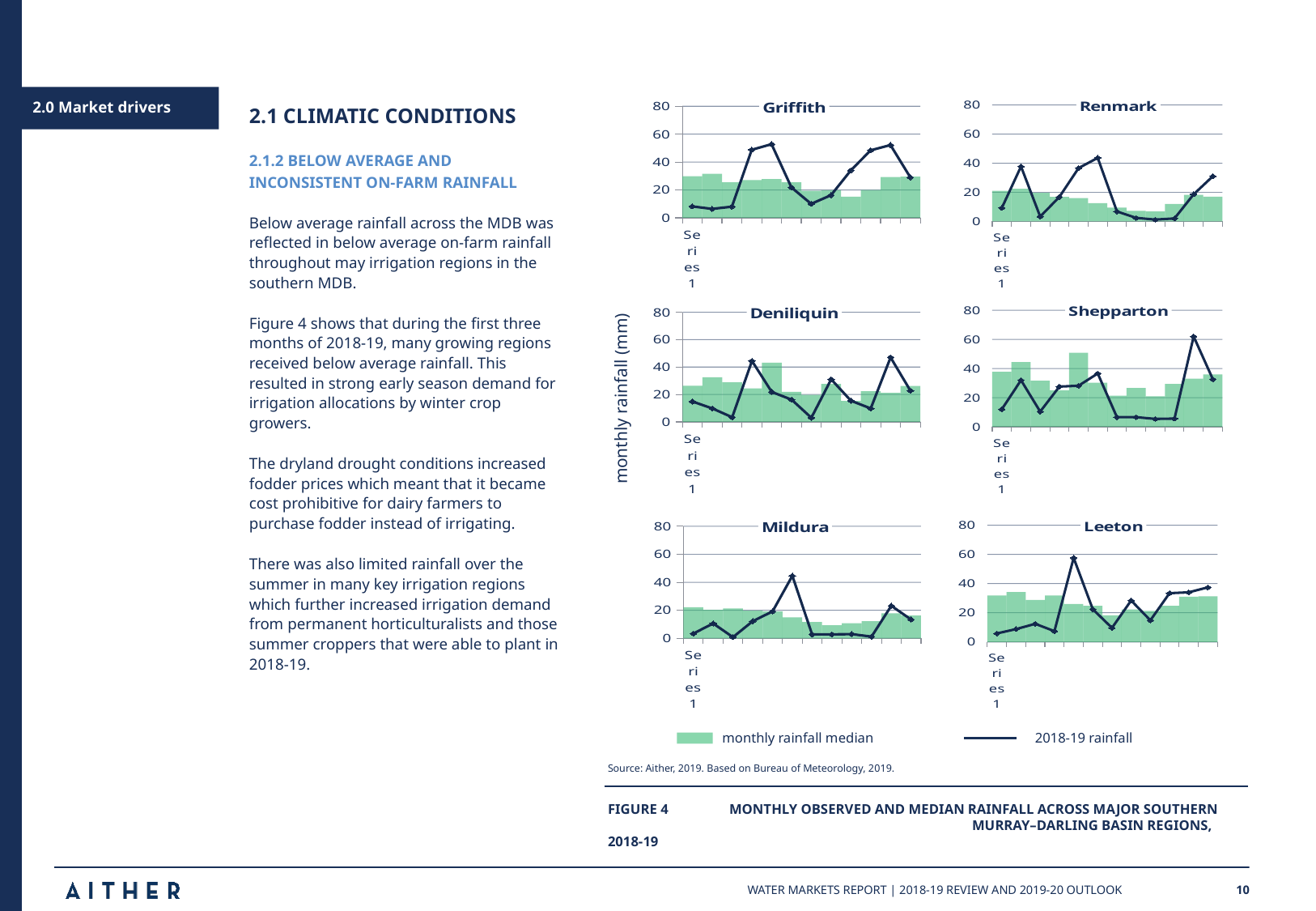
What kind of chart is used to show the 2018-19 rainfall in each region? line chart How many series does the legend list for the rainfall charts? 2 In the Renmark chart, is the highest value of the 2018-19 rainfall line greater or less than 60? less In the Griffith chart, is the highest value of the 2018-19 rainfall line greater or less than 40? greater In the Mildura chart, is the highest value of the 2018-19 rainfall line greater or less than 60? less Which chart shows a higher peak in the 2018-19 rainfall line, Leeton or Mildura? Leeton How many regional rainfall charts are shown on the slide? 6 What is the label on the shared vertical axis of the rainfall charts? monthly rainfall (mm) Which chart shows a higher peak in the 2018-19 rainfall line, Shepparton or Deniliquin? Shepparton